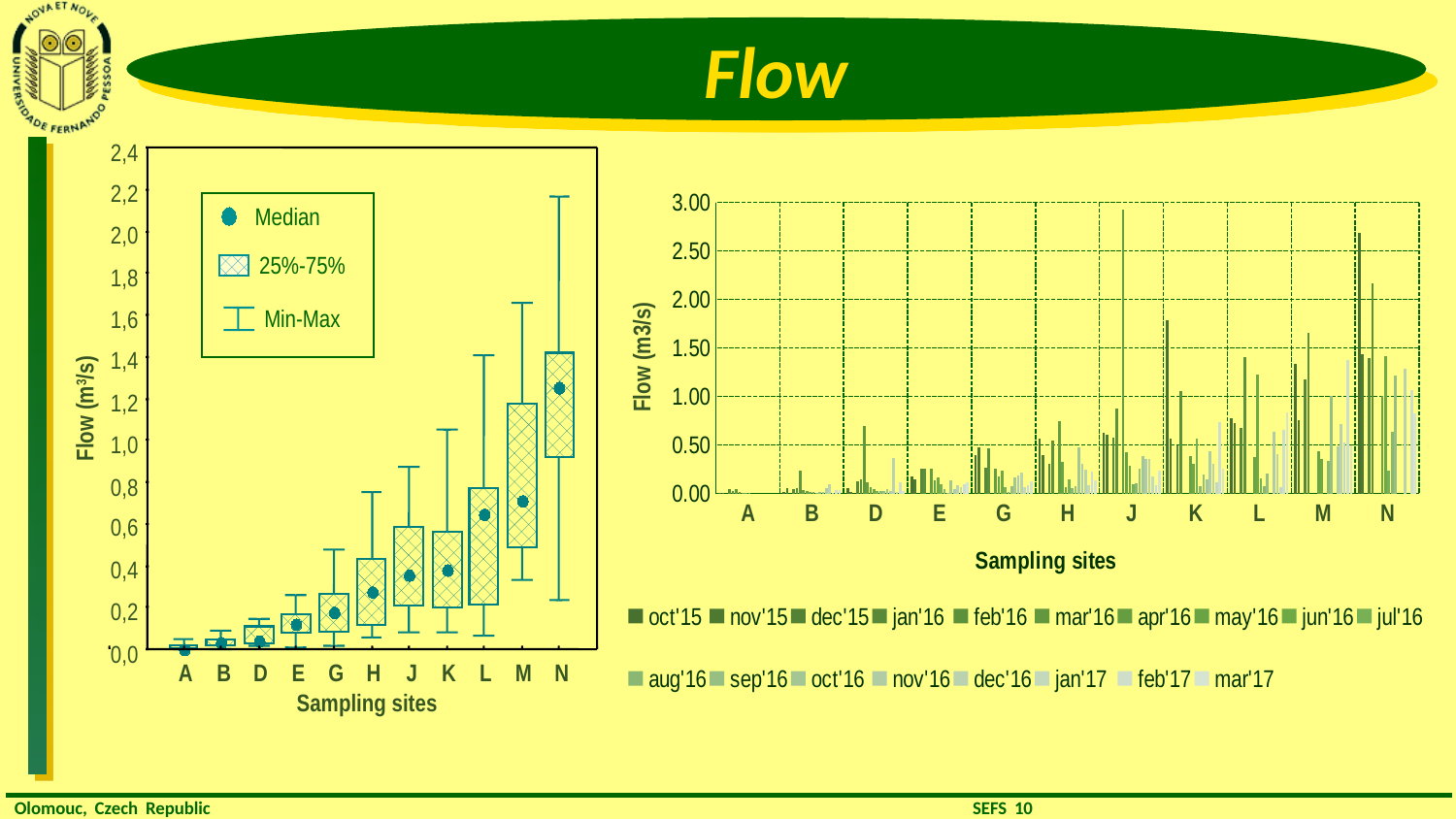
In the left chart, which sampling site has the highest median flow? N In the left chart, which site has the larger median flow, H or L? L What are the three legend entries of the left chart? Median, 25%-75%, Min-Max How many series does the legend of the right chart list? 18 In the left chart, which sampling site has the lowest median flow? A In the left chart, is the median flow for site N greater or less than 1,0? greater How many sampling sites are shown on the x axis of the left chart? 11 In the right chart, is the tallest bar at site J greater or less than 2.50? greater In the left chart, is the median flow for site M greater or less than 1,0? less In the left chart, do the median flow values rise or fall from site A to site N? rise What kind of chart is the chart on the left of the slide? box plot What kind of chart is the chart on the right of the slide? bar chart